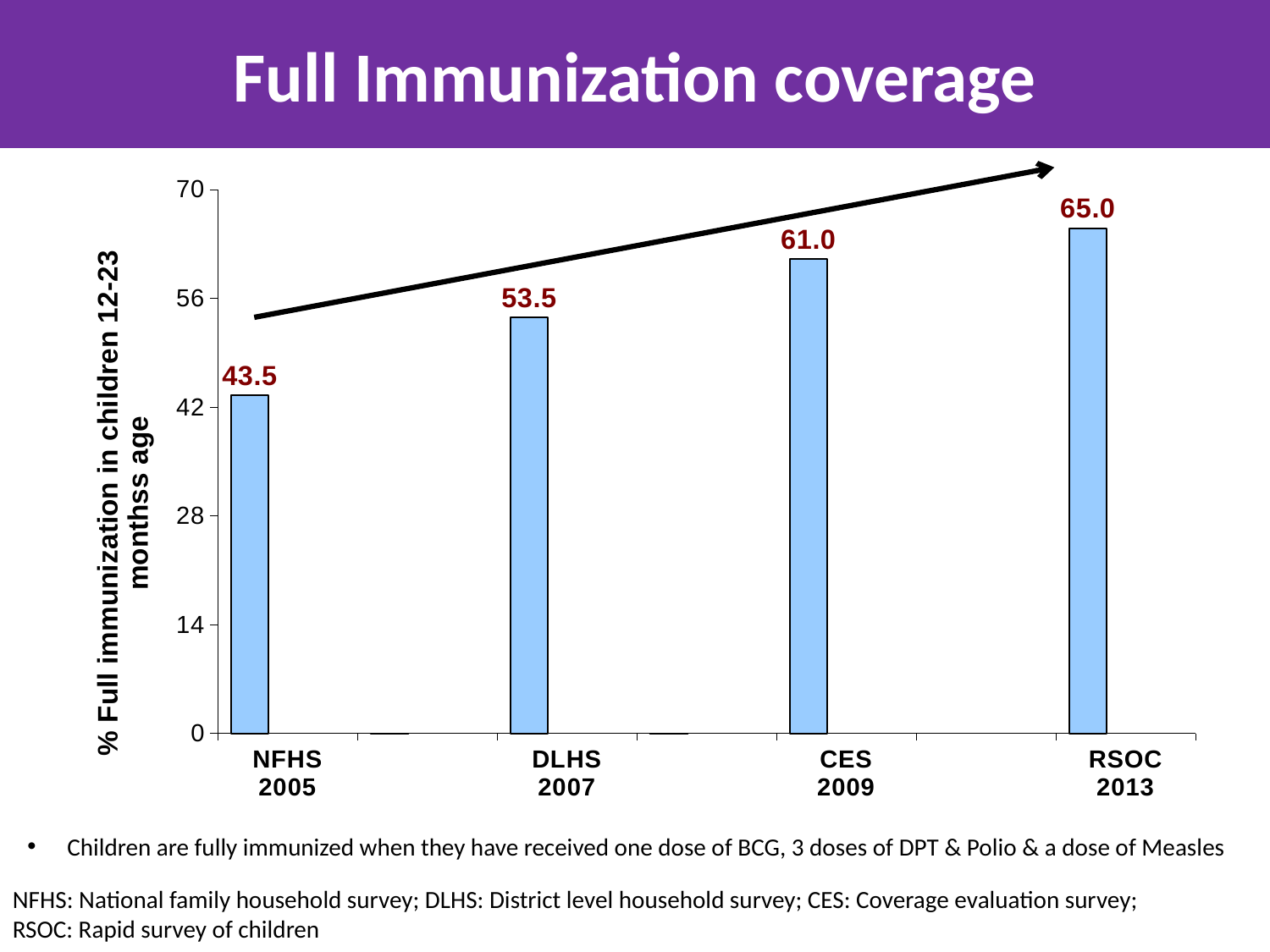
What is the value shown for DLHS 2007? 53.5 What is the difference between the RSOC 2013 value and the NFHS 2005 value? 21.5 What kind of chart is shown on the slide? bar chart What is the value shown for CES 2009? 61.0 Is the value for NFHS 2005 greater or less than 42? greater Which survey shows the lowest full immunization coverage? NFHS 2005 Which survey shows the highest full immunization coverage? RSOC 2013 Which is larger, the value for DLHS 2007 or the value for CES 2009? CES 2009 What is the value shown for RSOC 2013? 65.0 Do the values rise or fall from NFHS 2005 to RSOC 2013? rise What is the full immunization coverage value for NFHS 2005? 43.5 How many surveys are shown on the chart? 4